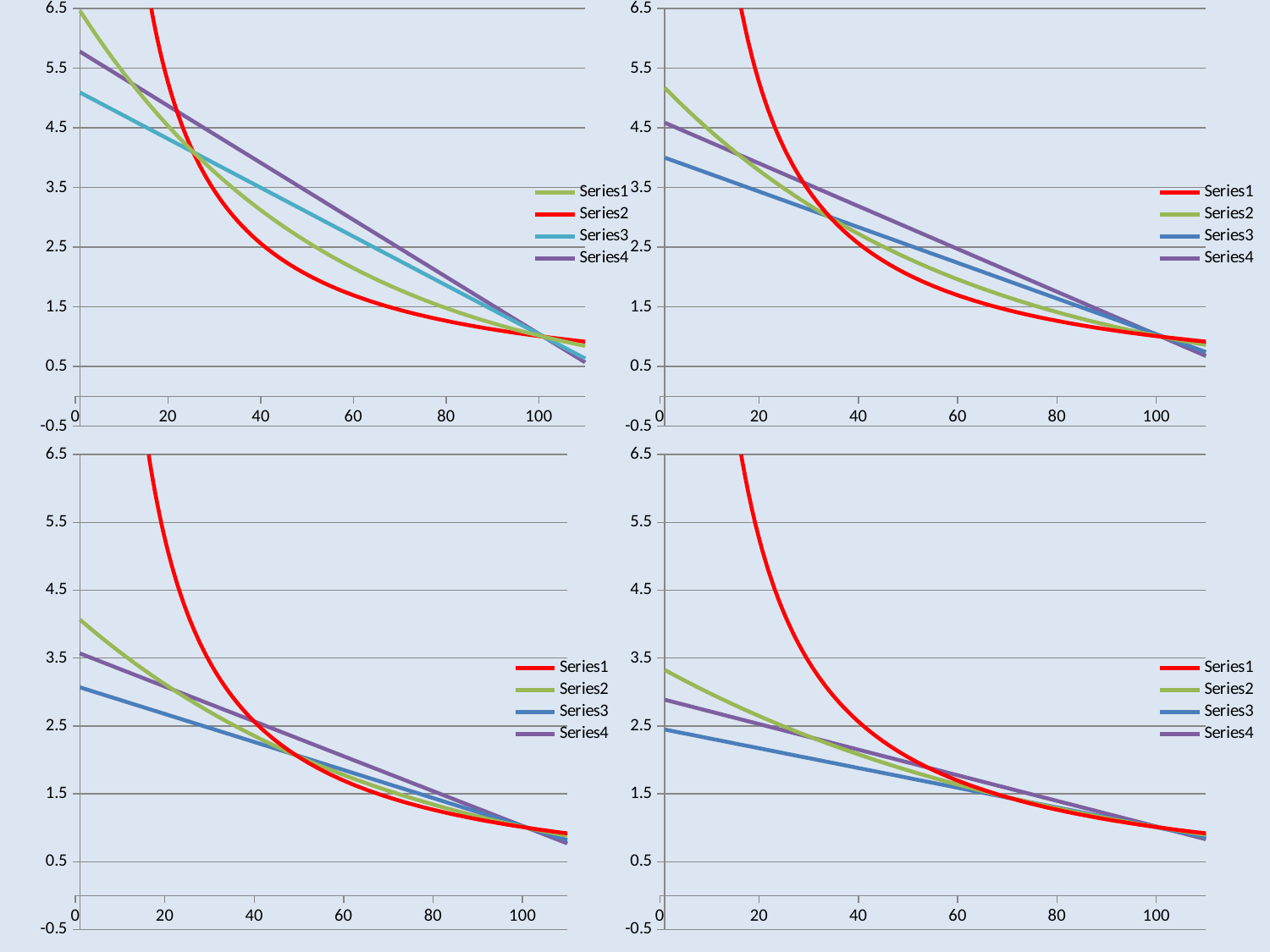
In the top-right chart, is the value of Series2 at x = 0 greater or less than 4.5? greater In the bottom-left chart, do the values of Series1 rise or fall as x increases? fall In the top-left chart, at x = 60, which is larger: Series1 or Series3? Series3 In the bottom-right chart, is the value of Series3 at x = 0 greater or less than 3.5? less In the bottom-right chart, at x = 20, which is larger: Series2 or Series3? Series2 In the top-left chart, which series has the lowest value at x = 0? Series3 What kind of chart is the top-left chart? line chart In the top-left chart, is the value of Series4 at x = 0 greater or less than 4.5? greater In the top-left chart, what colour is the line for Series2? red In the bottom-right chart, which series has the lowest value at x = 0? Series3 How many series does the legend of the top-right chart list? 4